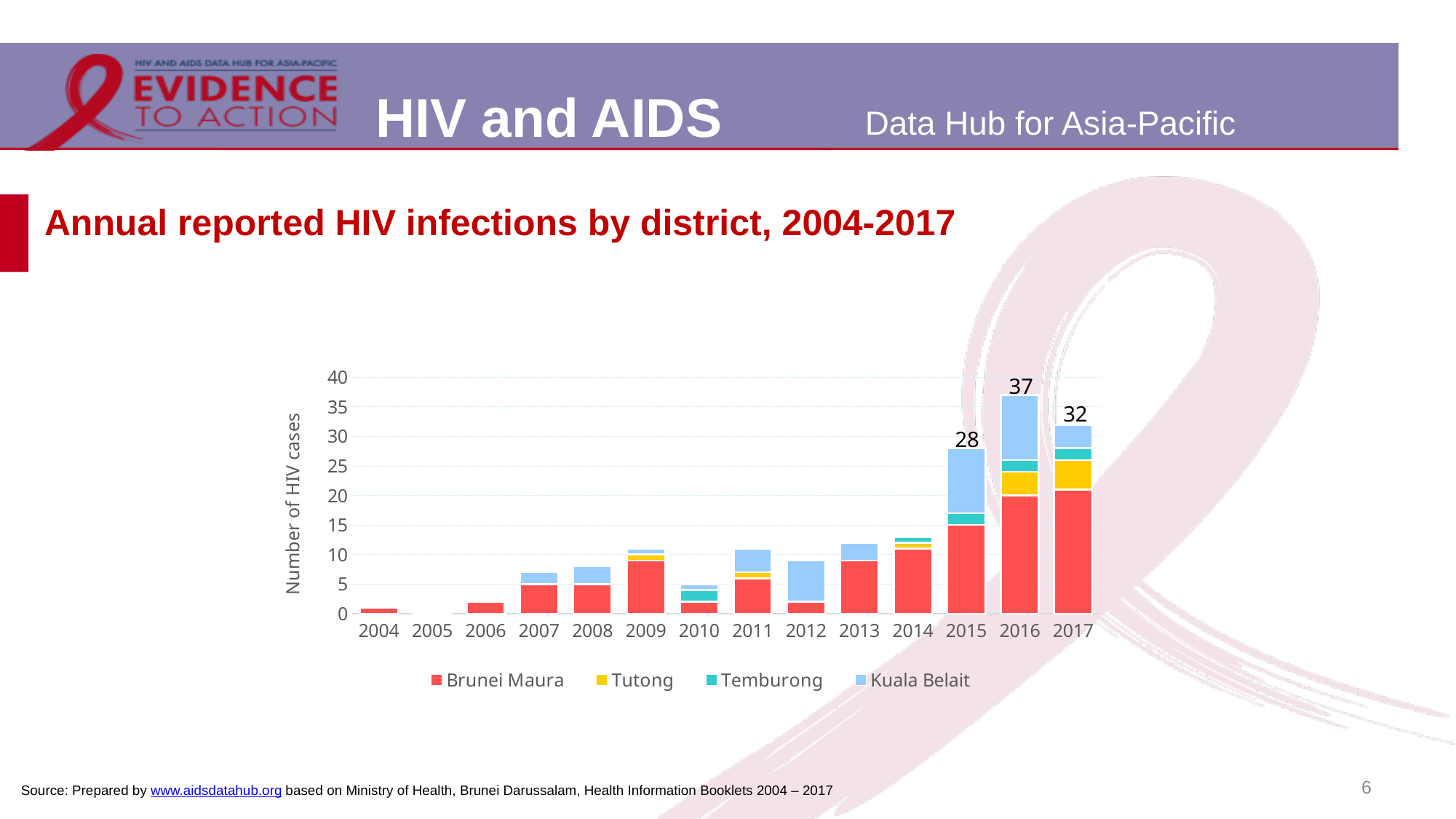
What is the difference between the total cases in 2016 and 2015? 9 What is the total number of HIV cases reported in 2015? 28 Which year has the highest total number of HIV cases? 2016 Which year has the lowest total number of HIV cases? 2005 Which year has a larger total of HIV cases, 2017 or 2015? 2017 How many series does the legend list? 4 What is the total number of HIV cases reported in 2016? 37 Do the total HIV cases rise or fall from 2014 to 2016? rise What is the label on the y axis? Number of HIV cases What kind of chart is shown on the slide? bar chart Is the total number of HIV cases in 2013 greater or less than 15? less How many years are shown on the x axis? 14